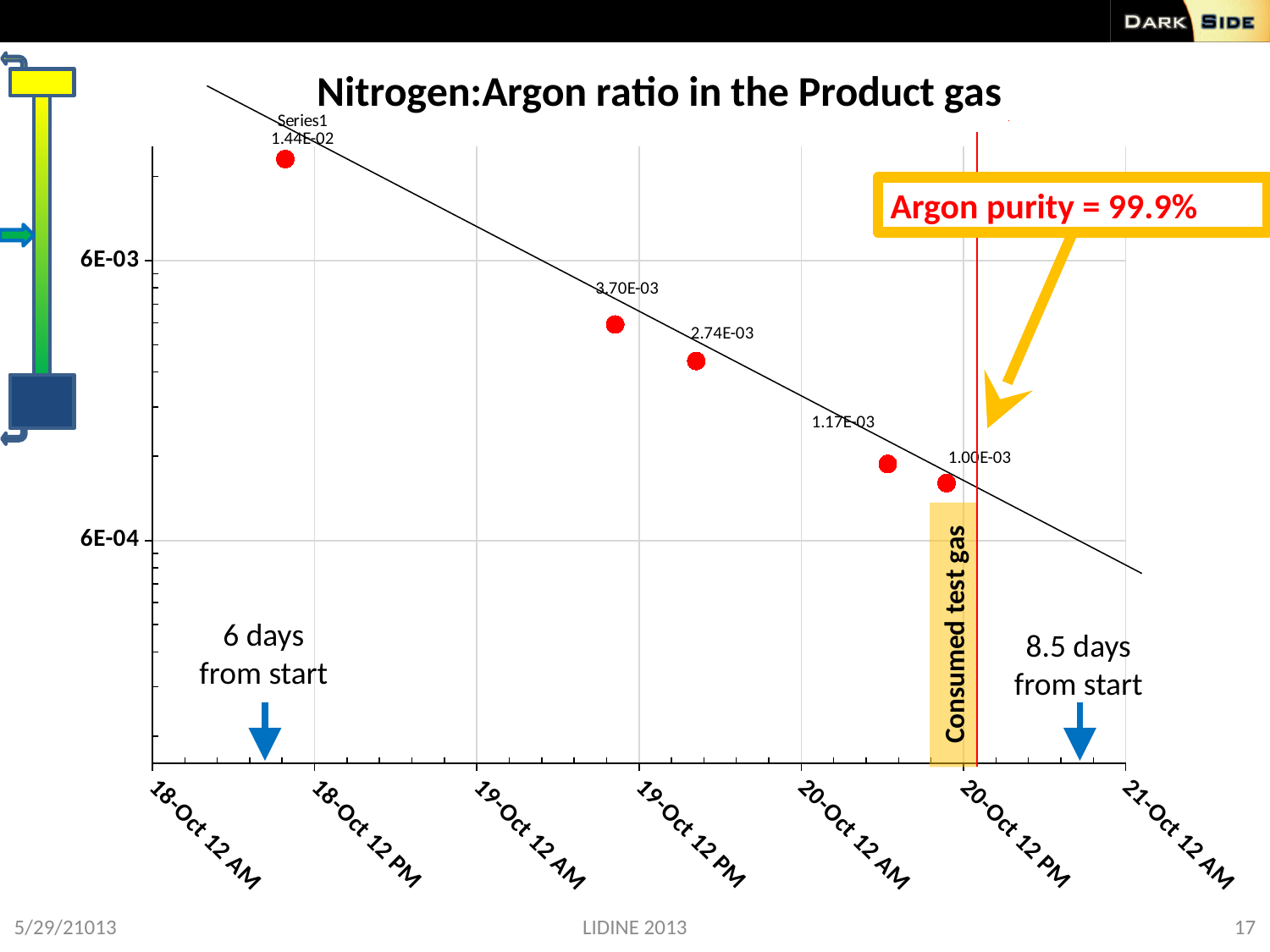
What is the value of the third data point, plotted just after 19-Oct 12 PM? 2.74E-03 What is the value of the fourth data point, plotted between 20-Oct 12 AM and 20-Oct 12 PM? 1.17E-03 Do the plotted values rise or fall over time along the x axis? fall How many data points are plotted on the chart? 5 What kind of chart is shown on the slide? scatter chart Is the value of the last data point greater or less than 6E-04? greater What is the value of the highest data point on the chart? 1.44E-02 Is the value of the first data point greater or less than 6E-03? greater Which is larger, the value of the data point labelled 3.70E-03 or the one labelled 2.74E-03? 3.70E-03 What is the value of the lowest data point on the chart? 1.00E-03 What is the title of the chart? Nitrogen:Argon ratio in the Product gas What is the value of the second data point (the one labelled just after 19-Oct 12 AM)? 3.70E-03